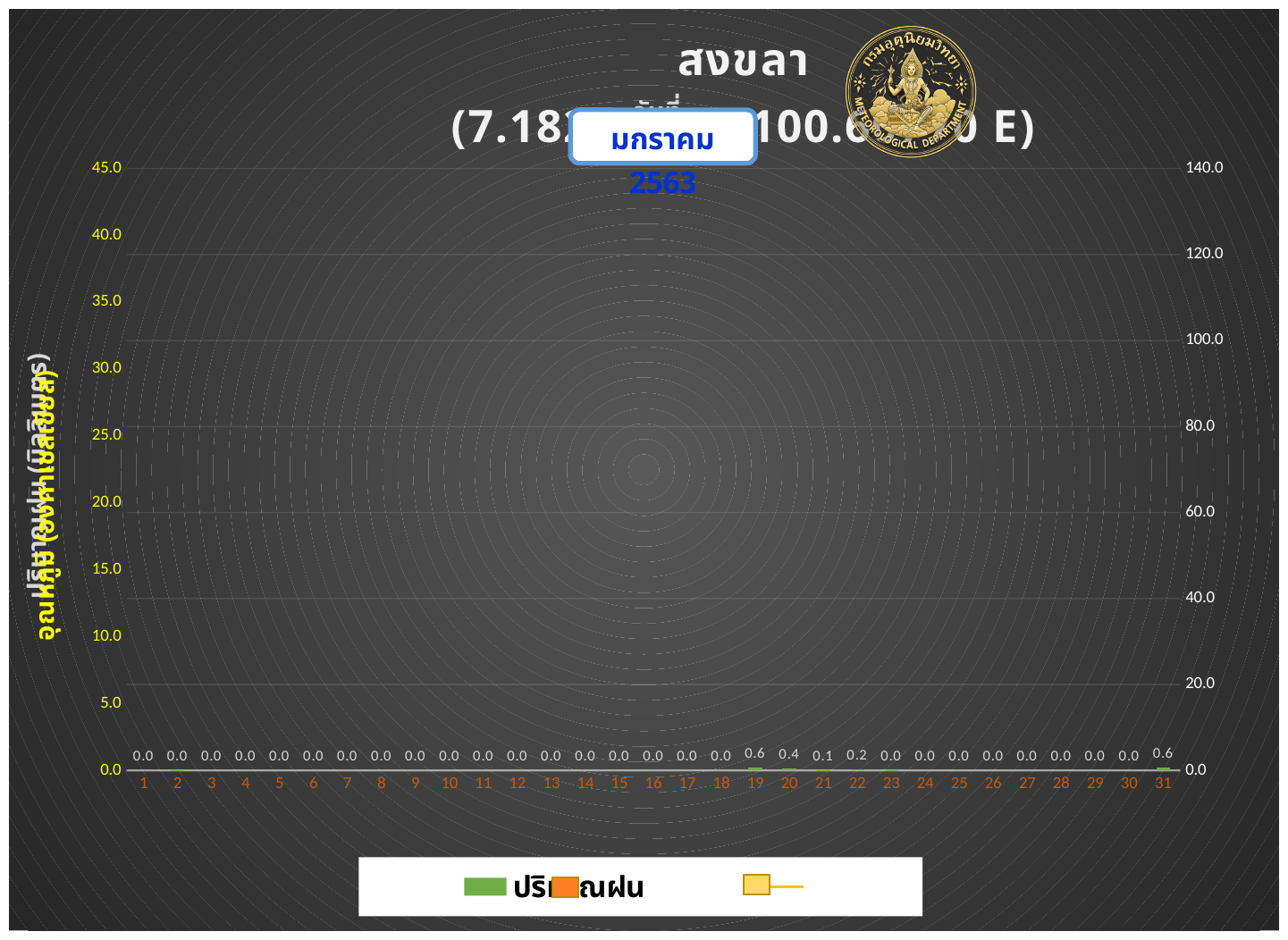
What is the value shown for day 20? 0.4 Is the value for day 19 greater or less than 5.0? less What is the difference between the values for day 19 and day 20? 0.2 What is the value shown for day 31? 0.6 What is the value shown for day 19? 0.6 What is the value shown for day 21? 0.1 What is the highest data-label value shown on the chart? 0.6 How many days are shown along the x axis? 31 What is the value shown for day 22? 0.2 Which has the larger value, day 20 or day 21? day 20 What kind of chart is shown on the slide? bar chart What is the value shown for day 10? 0.0